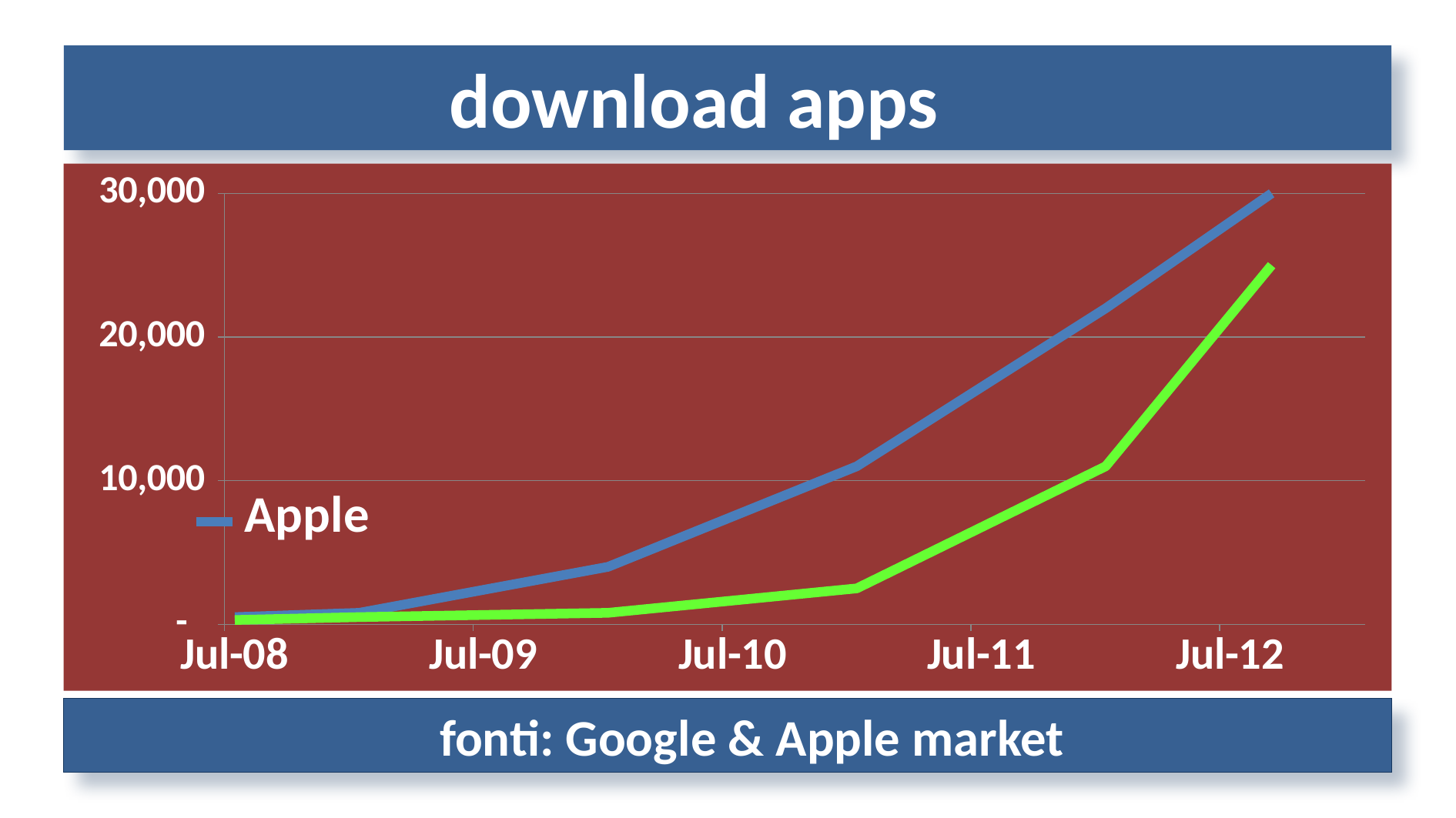
Which series is named in the chart's legend? Apple Does the Apple line rise or fall from Jul-08 to Jul-12? rise What is the title of the chart? download apps What kind of chart is shown on the slide? line chart Is the Apple value at Jul-12 greater or less than 20,000? greater At which x-axis date does the Apple line reach its highest value? Jul-12 Is the Apple value at Jul-10 greater or less than 10,000? less How many dates are labelled on the x axis? 5 Is the Apple value at Jul-11 greater or less than 10,000? greater At Jul-12, which line is higher, the Apple line or the green line? Apple